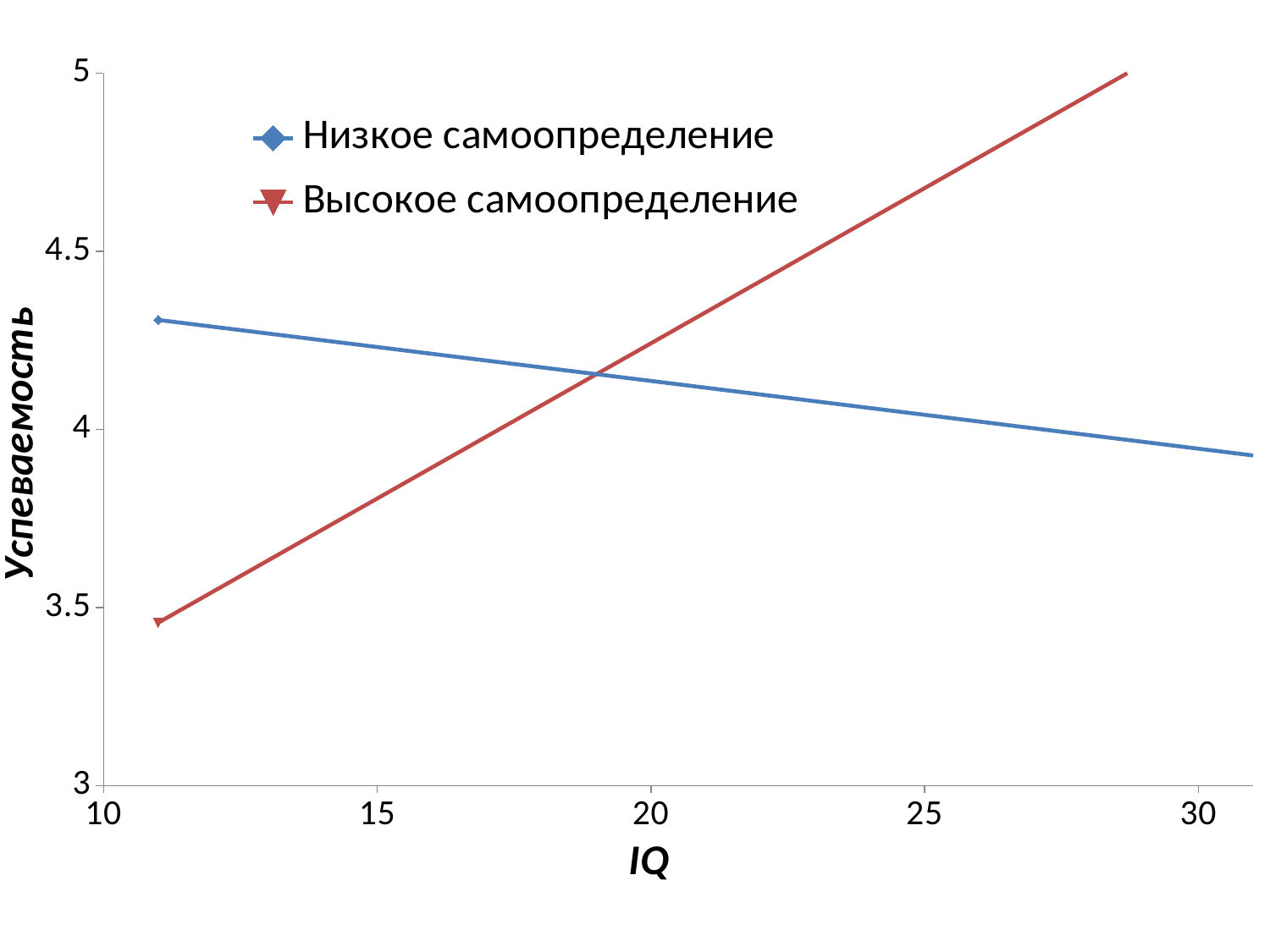
At IQ 25, which series has the higher Успеваемость value: Низкое самоопределение or Высокое самоопределение? Высокое самоопределение What is the label of the y axis? Успеваемость What kind of chart is shown on the slide? line chart Is the value of Высокое самоопределение at IQ 25 greater or less than 4? greater Does the value for Высокое самоопределение rise or fall as IQ increases? rise What is the label of the x axis? IQ Is the starting value of Высокое самоопределение (at the left end of the line) greater or less than 4? less At IQ 15, which series has the higher Успеваемость value: Низкое самоопределение or Высокое самоопределение? Низкое самоопределение Is the starting value of Низкое самоопределение (at the left end of the line) greater or less than 4? greater How many series does the legend list? 2 Does the value for Низкое самоопределение rise or fall as IQ increases? fall